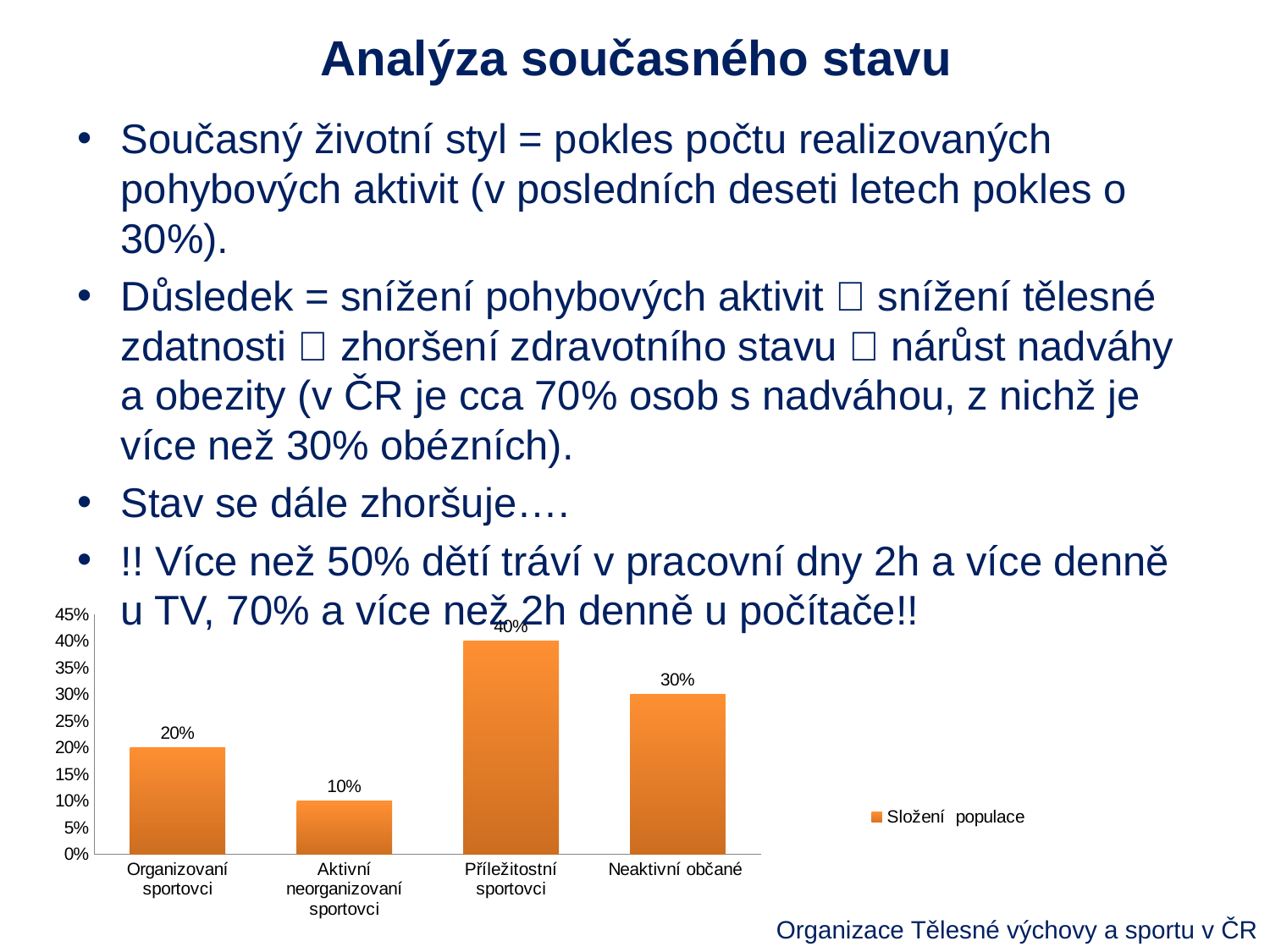
What is the difference between the values for Příležitostní sportovci and Neaktivní občané? 10% What is the name of the series shown in the chart legend? Složení populace What is the value for Příležitostní sportovci? 40% What is the value for Organizovaní sportovci? 20% What is the value for Aktivní neorganizovaní sportovci? 10% What kind of chart is shown on the slide? bar chart Which is larger, the value for Organizovaní sportovci or the value for Neaktivní občané? Neaktivní občané Which category has the highest value? Příležitostní sportovci Which category has the lowest value? Aktivní neorganizovaní sportovci What is the value for Neaktivní občané? 30% How many series does the chart legend list? 1 How many categories are shown on the x axis of the chart? 4